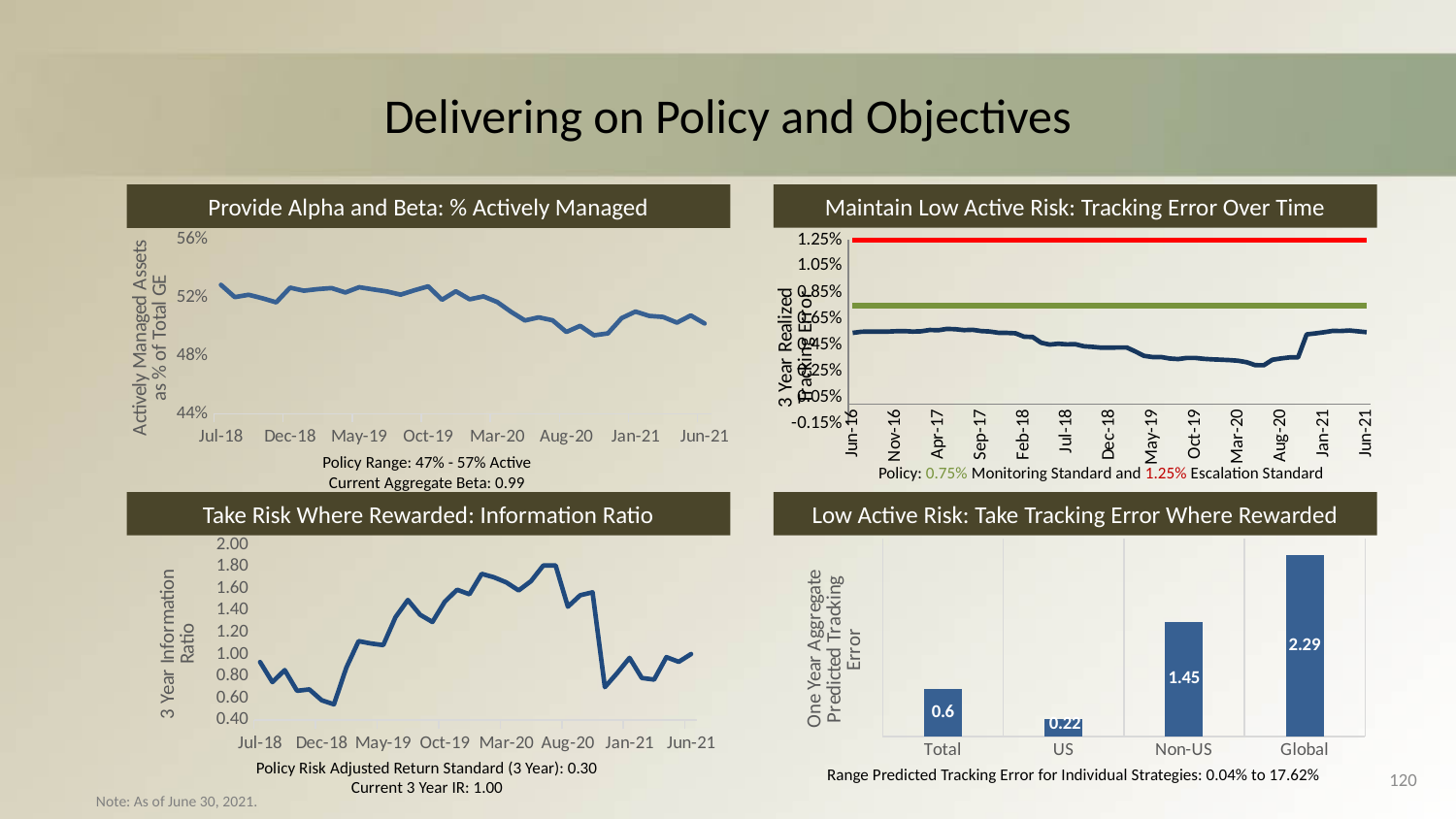
In the 'Maintain Low Active Risk: Tracking Error Over Time' chart, is the realized tracking error at Jun-21 greater or less than 0.75%? less In the 'Maintain Low Active Risk: Tracking Error Over Time' chart, does the realized tracking error generally rise or fall from Jun-16 to Mar-20? Fall In the 'Low Active Risk: Take Tracking Error Where Rewarded' chart, which is larger, Total or Non-US? Non-US How many categories are shown in the 'Low Active Risk: Take Tracking Error Where Rewarded' chart? 4 In the 'Low Active Risk: Take Tracking Error Where Rewarded' chart, what is the value for US? 0.22 In the 'Low Active Risk: Take Tracking Error Where Rewarded' chart, which category has the highest value? Global In the 'Low Active Risk: Take Tracking Error Where Rewarded' chart, what is the value for Global? 2.29 In the 'Low Active Risk: Take Tracking Error Where Rewarded' chart, what is the difference between the Global and Non-US values? 0.84 In the 'Low Active Risk: Take Tracking Error Where Rewarded' chart, which category has the lowest value? US What kind of chart is 'Low Active Risk: Take Tracking Error Where Rewarded'? Bar chart What kind of chart is 'Provide Alpha and Beta: % Actively Managed'? Line chart In the 'Provide Alpha and Beta: % Actively Managed' chart, is the value at Jul-18 greater or less than 48%? greater